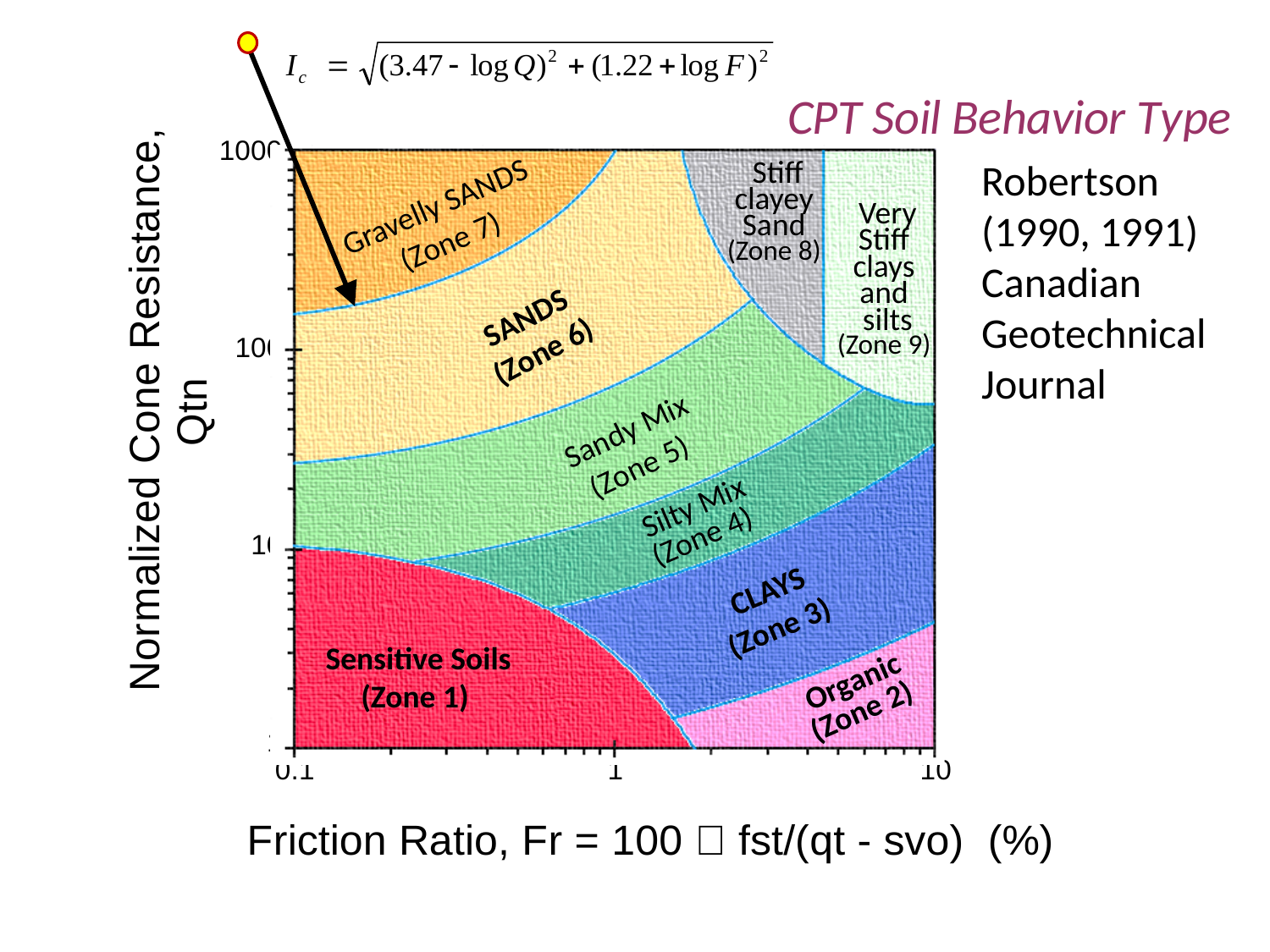
Which soil type is labeled as Zone 9 on the chart? Very Stiff clays and silts Which zone occupies the bottom-left corner of the chart? Sensitive Soils (Zone 1) What is the lowest tick value shown on the x axis (Friction Ratio)? 0.1 Which soil type is labeled as Zone 3 on the chart? CLAYS Which soil type is labeled as Zone 1 on the chart? Sensitive Soils Which zone number is assigned to Silty Mix on the chart? Zone 4 What quantity is plotted on the x axis of the chart? Friction Ratio, Fr (%) What is the highest tick value shown on the y axis (Normalized Cone Resistance, Qtn)? 1000 Which soil type is labeled as Zone 7 on the chart? Gravelly SANDS Which zone number is assigned to Organic soils on the chart? Zone 2 How many soil behavior zones are labeled on the chart? 9 What is the title of the chart shown on the slide? CPT Soil Behavior Type